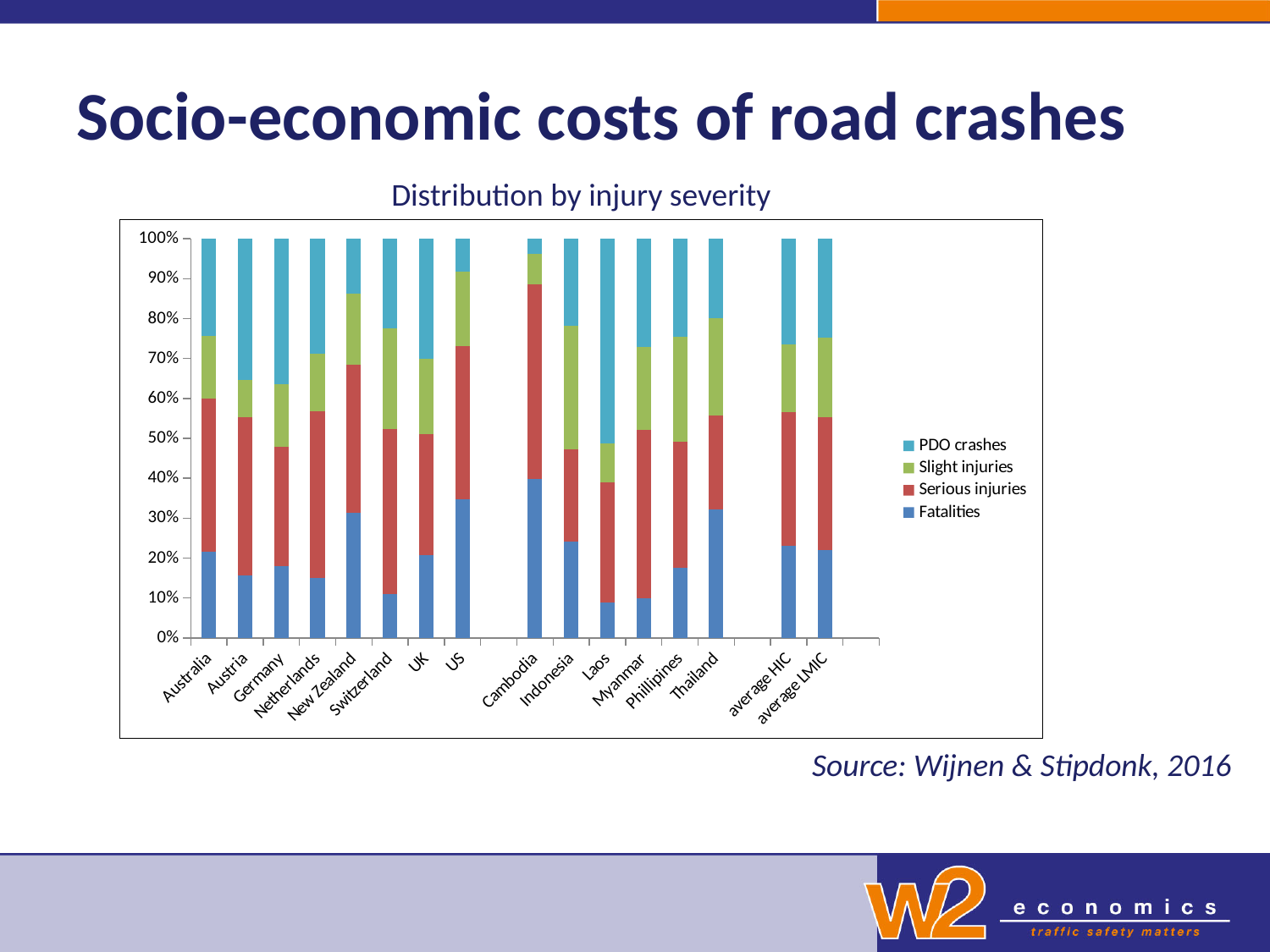
What is the total of the stacked bar for Australia? 100% How many series does the chart's legend list? 4 Which category has the largest PDO crashes share? Laos How many countries or categories are shown along the x axis of the chart? 16 What is the title of the chart? Distribution by injury severity Which has a larger Fatalities share, Cambodia or Switzerland? Cambodia Which category has the largest Fatalities share? Cambodia Which series in the legend is shown in blue at the bottom of each bar? Fatalities Is the PDO crashes share for Cambodia greater or less than 10%? less Is the Fatalities share for Switzerland greater or less than 20%? less Is the Fatalities share for Cambodia greater or less than 30%? greater What kind of chart is shown on the slide? Stacked bar chart